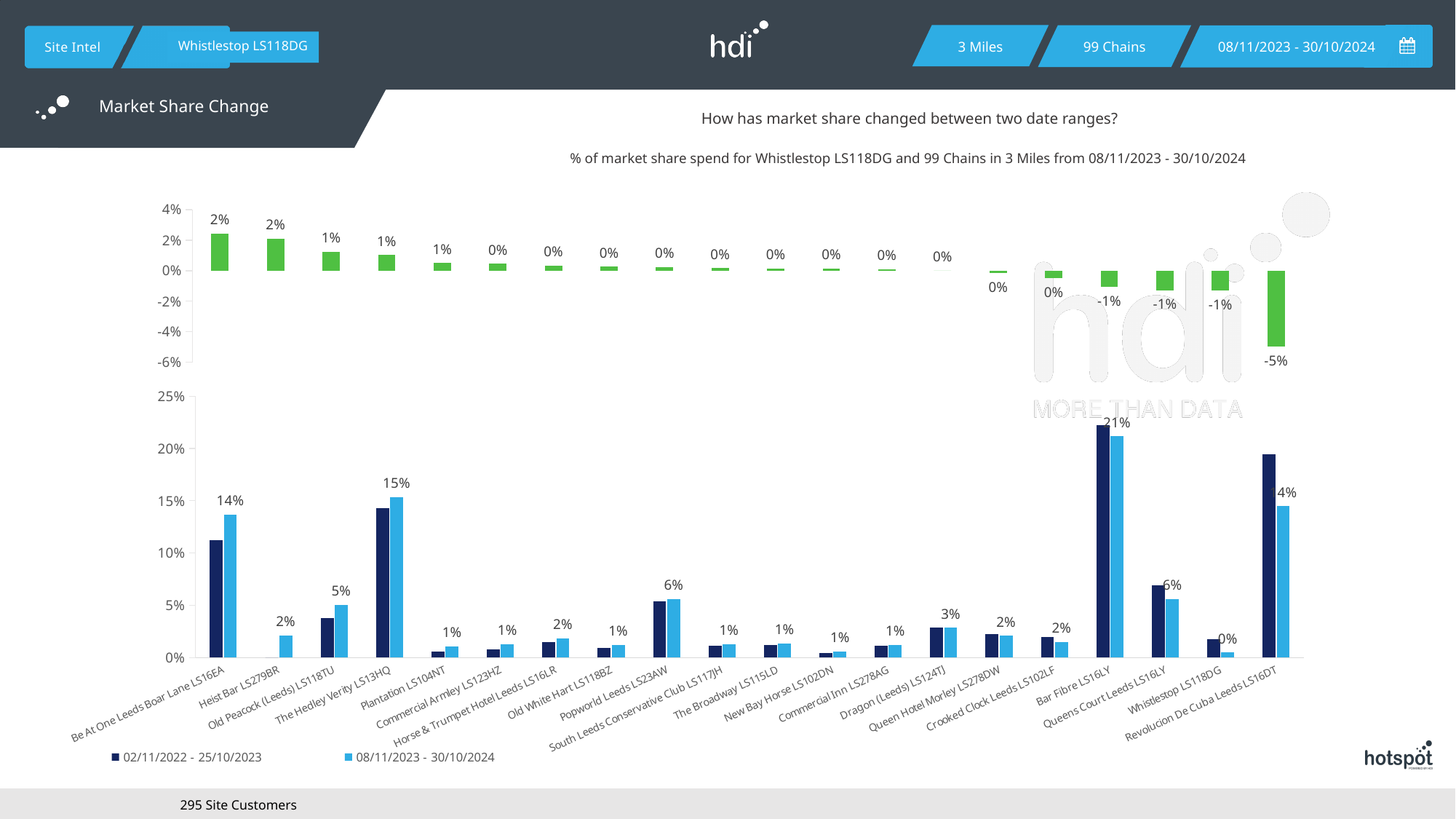
In the bottom chart, for Be At One Leeds Boar Lane LS16EA, which series has the larger value: 02/11/2022 - 25/10/2023 or 08/11/2023 - 30/10/2024? 08/11/2023 - 30/10/2024 In the bottom chart, how many series does the legend list? 2 In the bottom chart, how many categories are shown on the x axis? 20 In the bottom chart, what is the difference between the 08/11/2023 - 30/10/2024 values for Bar Fibre LS16LY and The Hedley Verity LS13HQ? 6% In the bottom chart, which category has the highest 08/11/2023 - 30/10/2024 value? Bar Fibre LS16LY In the top chart (market share change), what is the value for Be At One Leeds Boar Lane LS16EA? 2% In the bottom chart, is the 02/11/2022 - 25/10/2023 value for Bar Fibre LS16LY greater or less than 20%? greater In the top chart (market share change), which category has the lowest value? Revolucion De Cuba Leeds LS16DT In the bottom chart, what is the 08/11/2023 - 30/10/2024 value for Bar Fibre LS16LY? 21% In the top chart (market share change), what is the value for Queens Court Leeds LS16LY? -1% In the top chart (market share change), what is the value for Revolucion De Cuba Leeds LS16DT? -5% What kind of chart is the bottom chart? bar chart